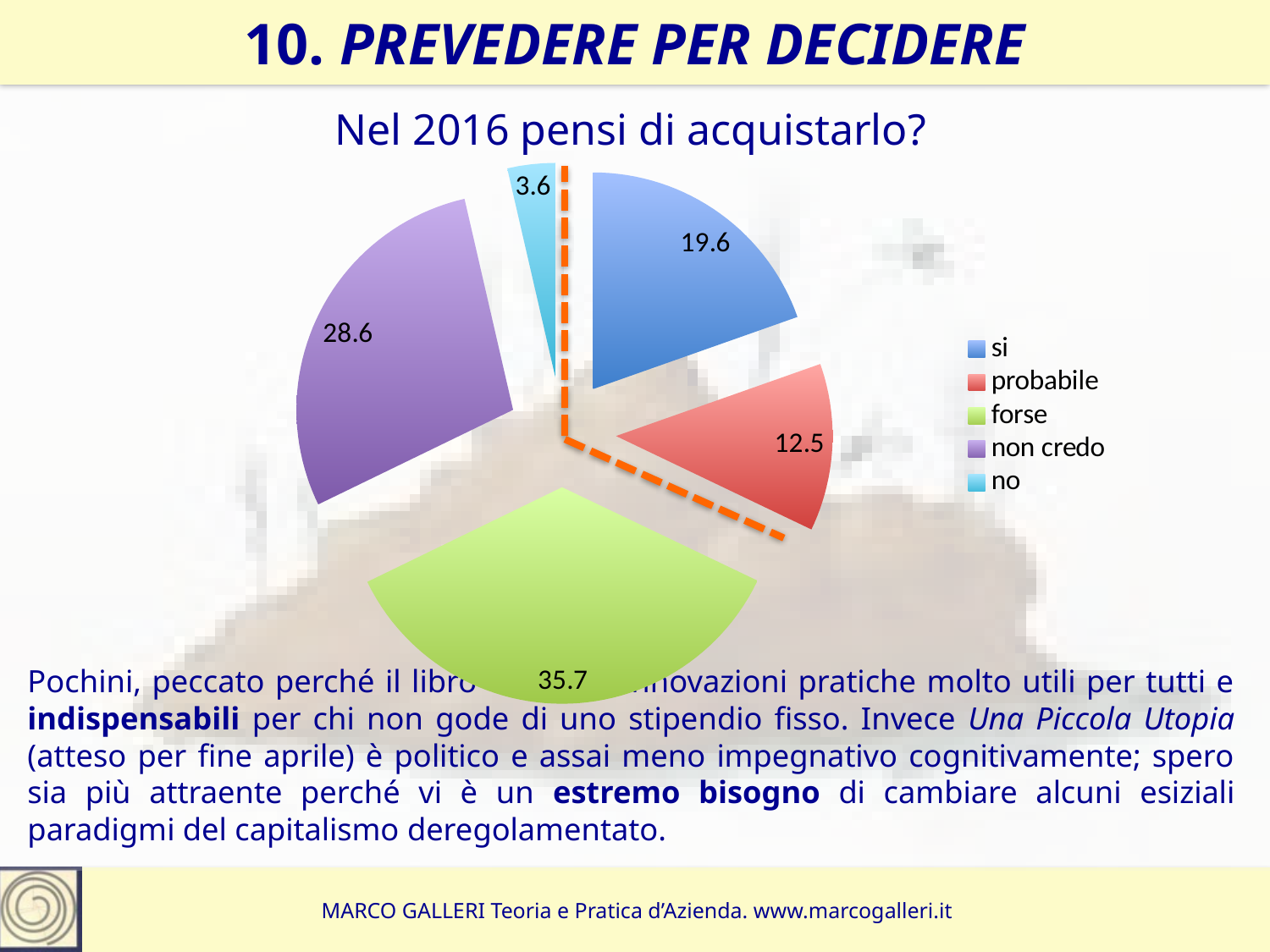
What kind of chart is shown on the slide? pie chart What is the difference between the values for "forse" and "non credo"? 7.1 What is the value for "non credo" in the pie chart? 28.6 What is the value for "no" in the pie chart? 3.6 What is the value for "probabile" in the pie chart? 12.5 Which category has the largest slice in the pie chart? forse How many categories does the pie chart show? 5 Which is larger, the value for "si" or the value for "probabile"? si What is the title of the chart? Nel 2016 pensi di acquistarlo? What is the value for "si" in the pie chart? 19.6 What is the value for "forse" in the pie chart? 35.7 Which category has the smallest slice in the pie chart? no